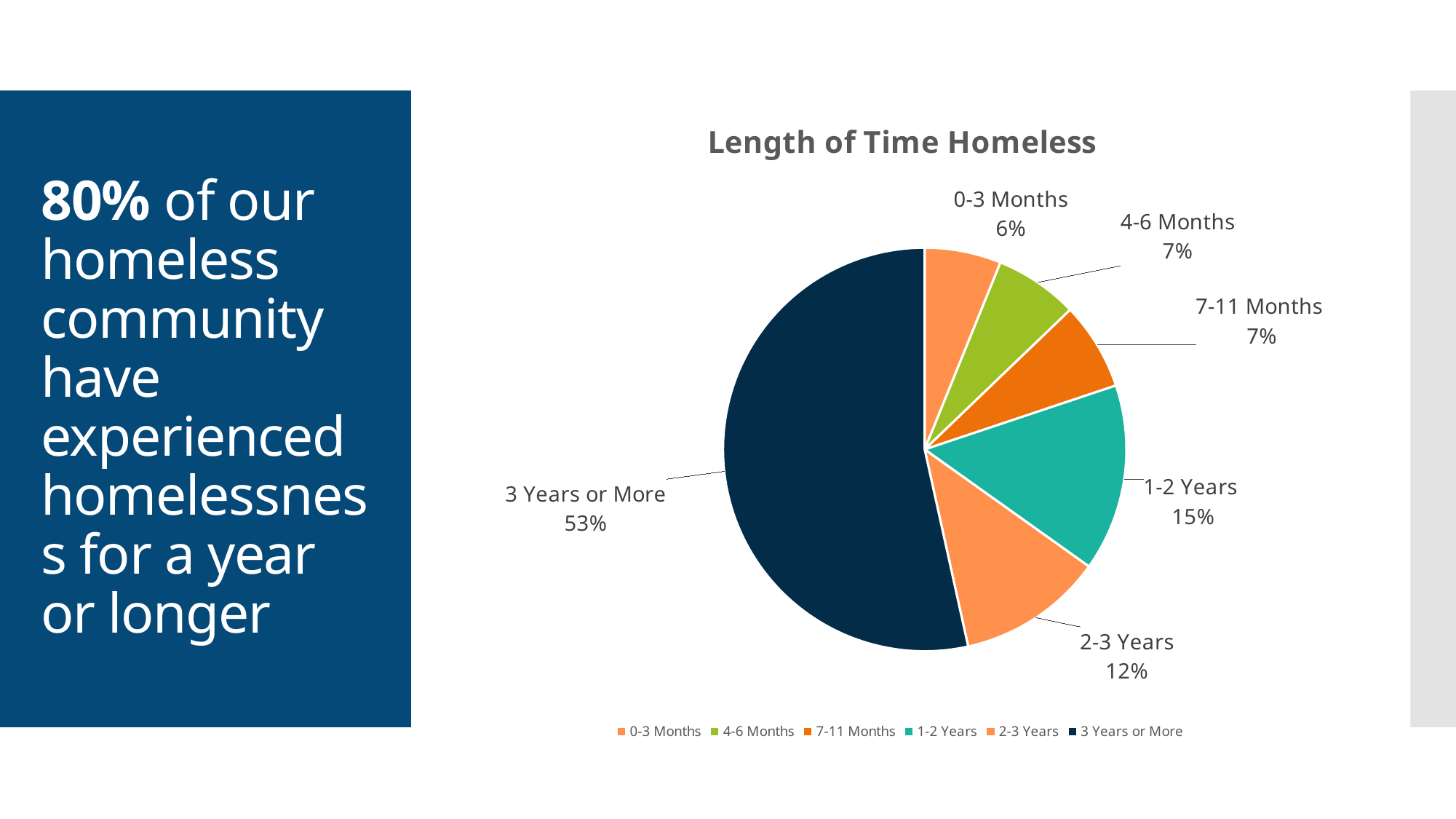
How many entries does the legend list? 6 What is the difference between the values for 1-2 Years and 2-3 Years? 3% Which category has the largest slice of the pie? 3 Years or More What is the title of the chart? Length of Time Homeless Which category has the smallest slice of the pie? 0-3 Months What is the value shown for 0-3 Months? 6% What share of the pie is labelled 3 Years or More? 53% What is the value shown for 1-2 Years? 15% Which is larger, the value for 4-6 Months or the value for 1-2 Years? 1-2 Years What is the value shown for 2-3 Years? 12% How many categories does the pie chart show? 6 What kind of chart is shown on the slide? pie chart